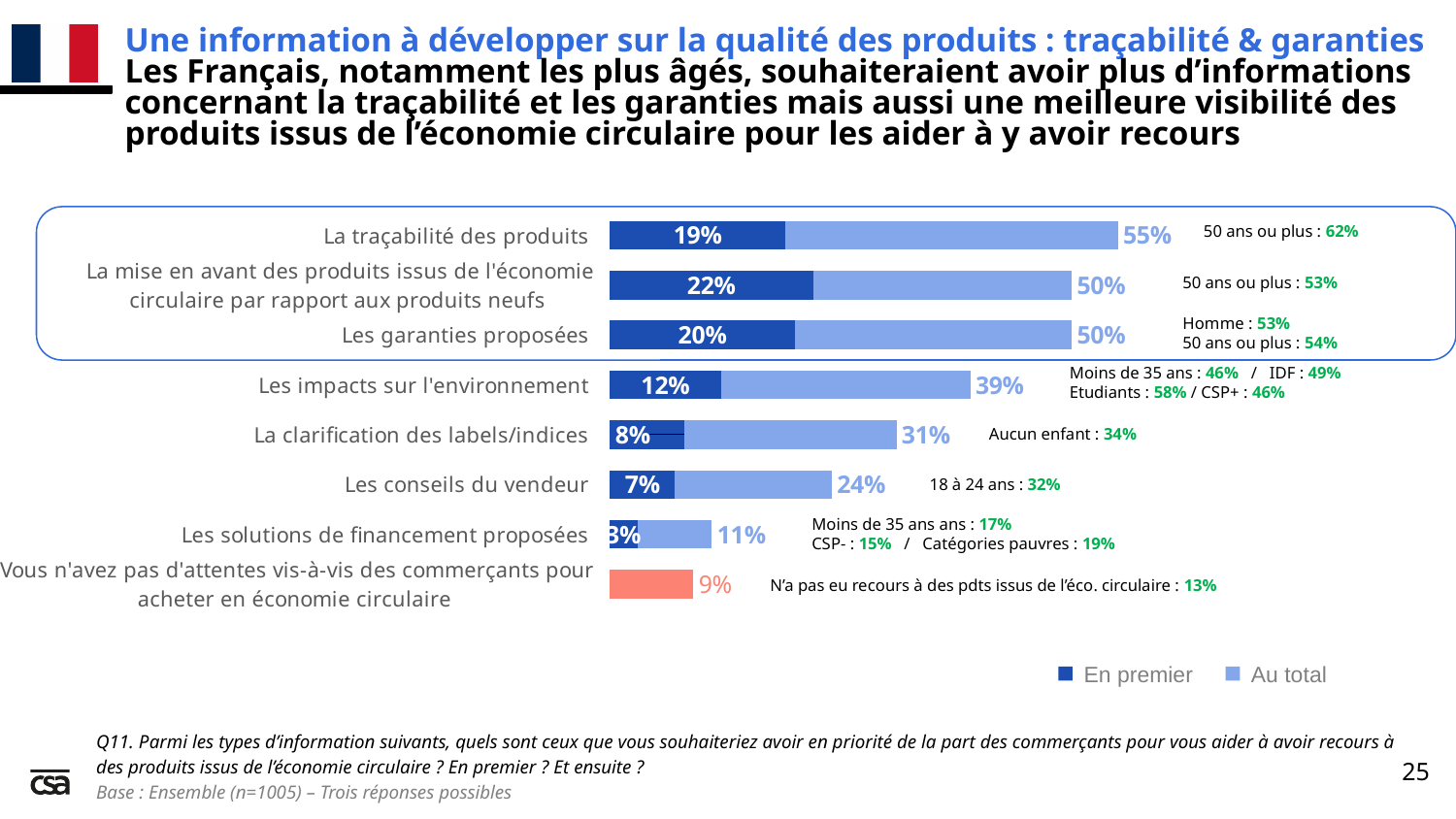
What is the 'Au total' value for 'La traçabilité des produits'? 55% What is the value shown for 'Vous n'avez pas d'attentes vis-à-vis des commerçants pour acheter en économie circulaire'? 9% Which is larger: the 'En premier' value for 'La clarification des labels/indices' or for 'Les conseils du vendeur'? La clarification des labels/indices What is the 'En premier' value for 'Les garanties proposées'? 20% What is the difference between the 'Au total' values for 'La traçabilité des produits' and 'Les conseils du vendeur'? 31% What is the 'Au total' value for 'Les impacts sur l'environnement'? 39% Which category has the highest 'Au total' value? La traçabilité des produits How many series does the legend list? 2 What kind of chart is shown on the slide? bar chart Which category has the highest 'En premier' value? La mise en avant des produits issus de l'économie circulaire par rapport aux produits neufs What is the 'En premier' value for 'Les solutions de financement proposées'? 3%